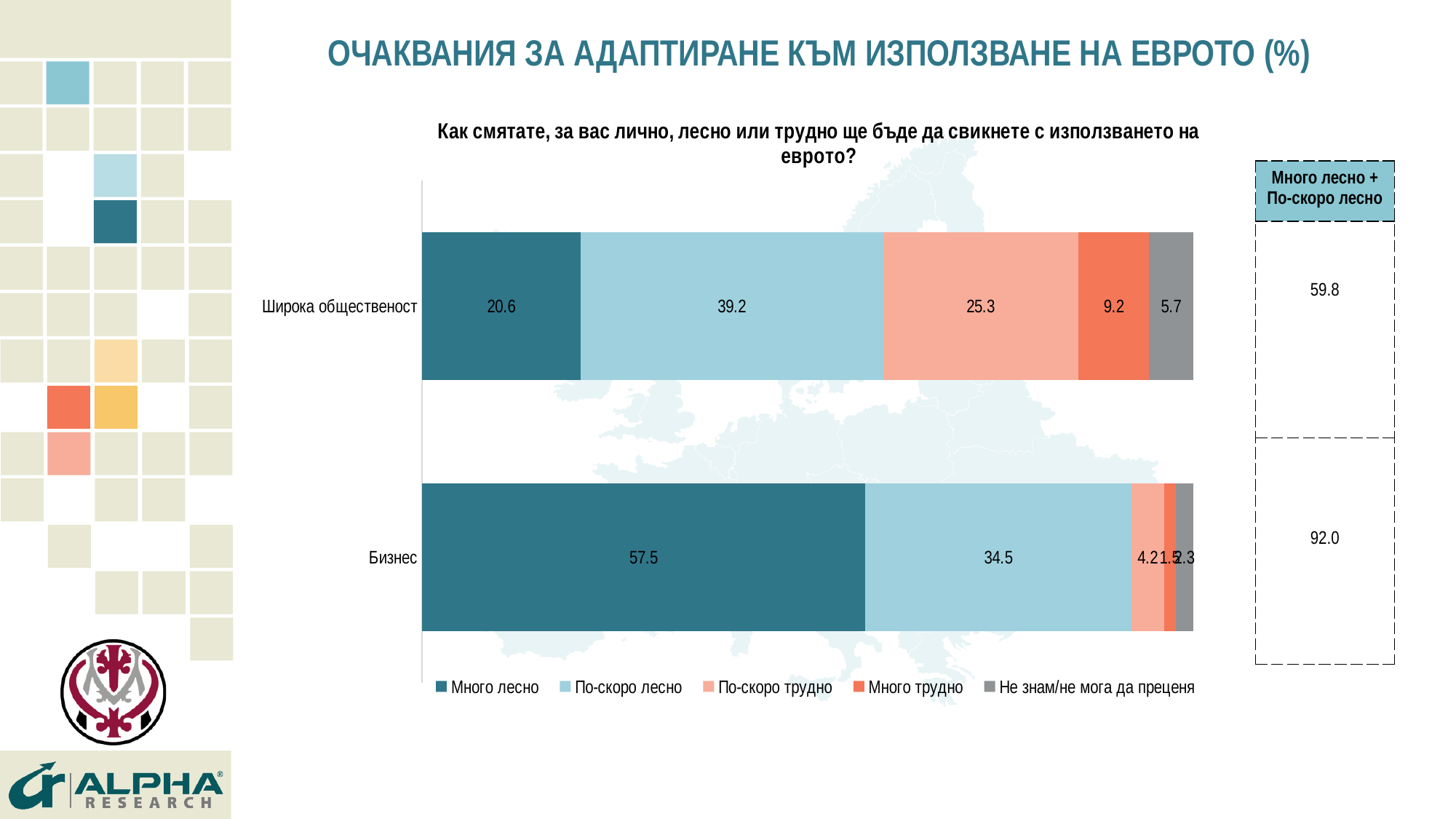
What is the difference between the "Много лесно" values for "Бизнес" and "Широка общественост"? 36.9 What is the combined "Много лесно + По-скоро лесно" value shown for "Бизнес" in the box to the right of the chart? 92.0 Which series has the largest value for "Широка общественост"? По-скоро лесно What is the value of "Не знам/не мога да преценя" for "Широка общественост"? 5.7 Which category has the higher value for "Много лесно", "Широка общественост" or "Бизнес"? Бизнес How many series does the legend list? 5 What is the value of "По-скоро лесно" for "Бизнес"? 34.5 What is the value of "По-скоро трудно" for "Широка общественост"? 25.3 How many categories are plotted in the chart? 2 What is the value of "Много трудно" for "Широка общественост"? 9.2 What kind of chart is shown on the slide? stacked bar chart What is the value of "Много лесно" for "Широка общественост"? 20.6